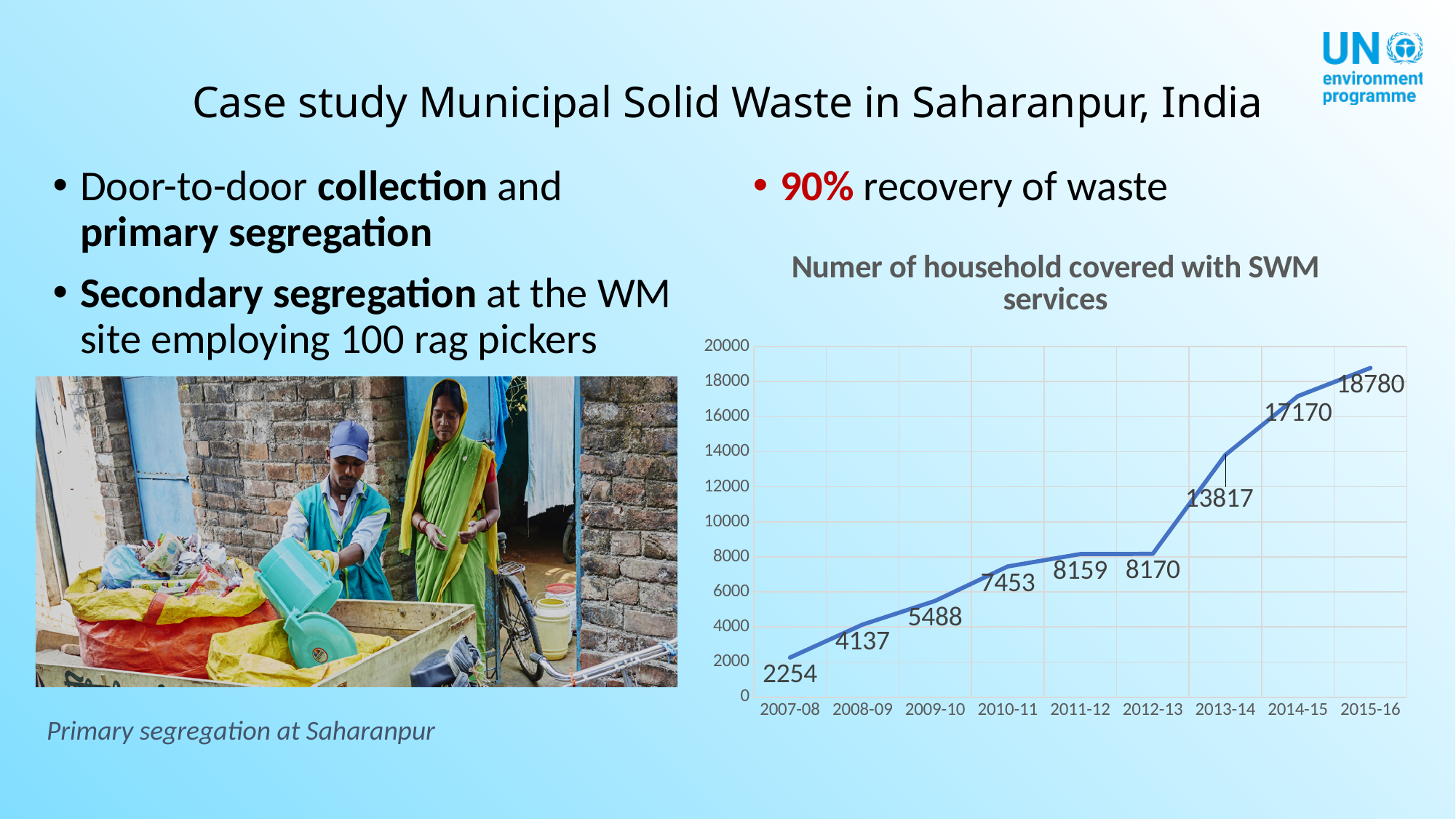
Which year has the lowest number of households covered with SWM services? 2007-08 What kind of chart is shown on the slide? Line chart Does the number of households covered rise or fall from 2007-08 to 2015-16? Rise Which year has more households covered, 2009-10 or 2010-11? 2010-11 Which year has the highest number of households covered with SWM services? 2015-16 What is the difference in households covered between 2012-13 and 2011-12? 11 What is the number of households covered with SWM services in 2013-14? 13817 How many years are plotted on the chart? 9 What is the difference in households covered between 2015-16 and 2014-15? 1610 What is the number of households covered with SWM services in 2007-08? 2254 Is the value for 2013-14 greater or less than 12000? greater What is the number of households covered with SWM services in 2011-12? 8159